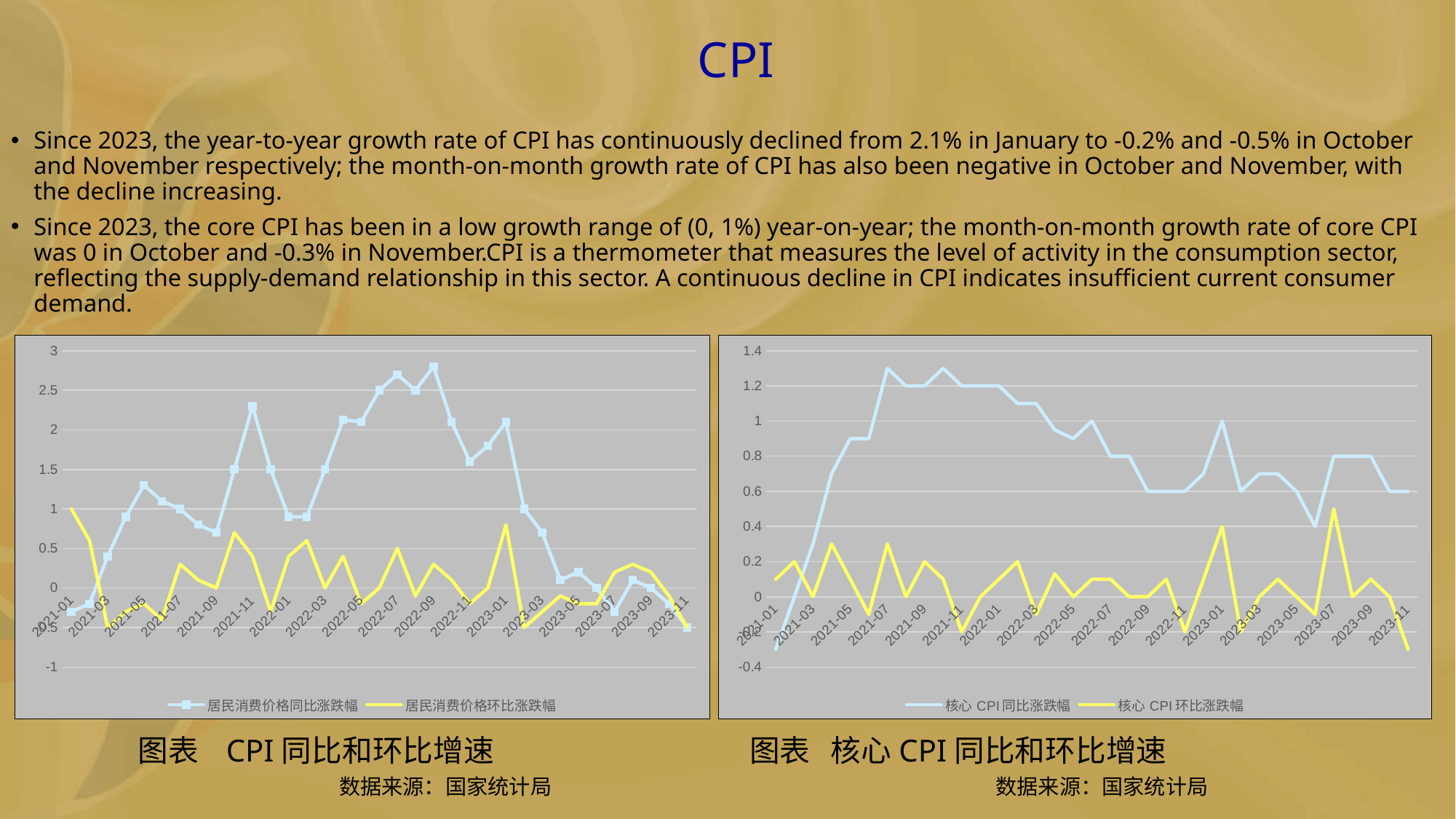
In the left chart (图表 CPI 同比和环比增速), at 2022-09 which series has the larger value, 居民消费价格同比涨跌幅 or 居民消费价格环比涨跌幅? 居民消费价格同比涨跌幅 In the left chart (图表 CPI 同比和环比增速), does 居民消费价格同比涨跌幅 rise or fall from 2023-01 to 2023-11? fall In the right chart (图表 核心 CPI 同比和环比增速), does 核心 CPI 同比涨跌幅 rise or fall from 2021-01 to 2021-07? rise In the right chart (图表 核心 CPI 同比和环比增速), is the value of 核心 CPI 同比涨跌幅 at 2021-07 greater or less than 1? greater How many series does the legend of the right chart (图表 核心 CPI 同比和环比增速) list? 2 In the left chart (图表 CPI 同比和环比增速), is the value of 居民消费价格同比涨跌幅 at 2022-09 greater or less than 2.5? greater In the right chart (图表 核心 CPI 同比和环比增速), which series is drawn in light blue? 核心 CPI 同比涨跌幅 In the left chart (图表 CPI 同比和环比增速), which series is drawn in yellow? 居民消费价格环比涨跌幅 In the right chart (图表 核心 CPI 同比和环比增速), is the value of 核心 CPI 环比涨跌幅 at 2023-11 greater or less than 0? less What kind of chart is the left chart (图表 CPI 同比和环比增速)? line chart